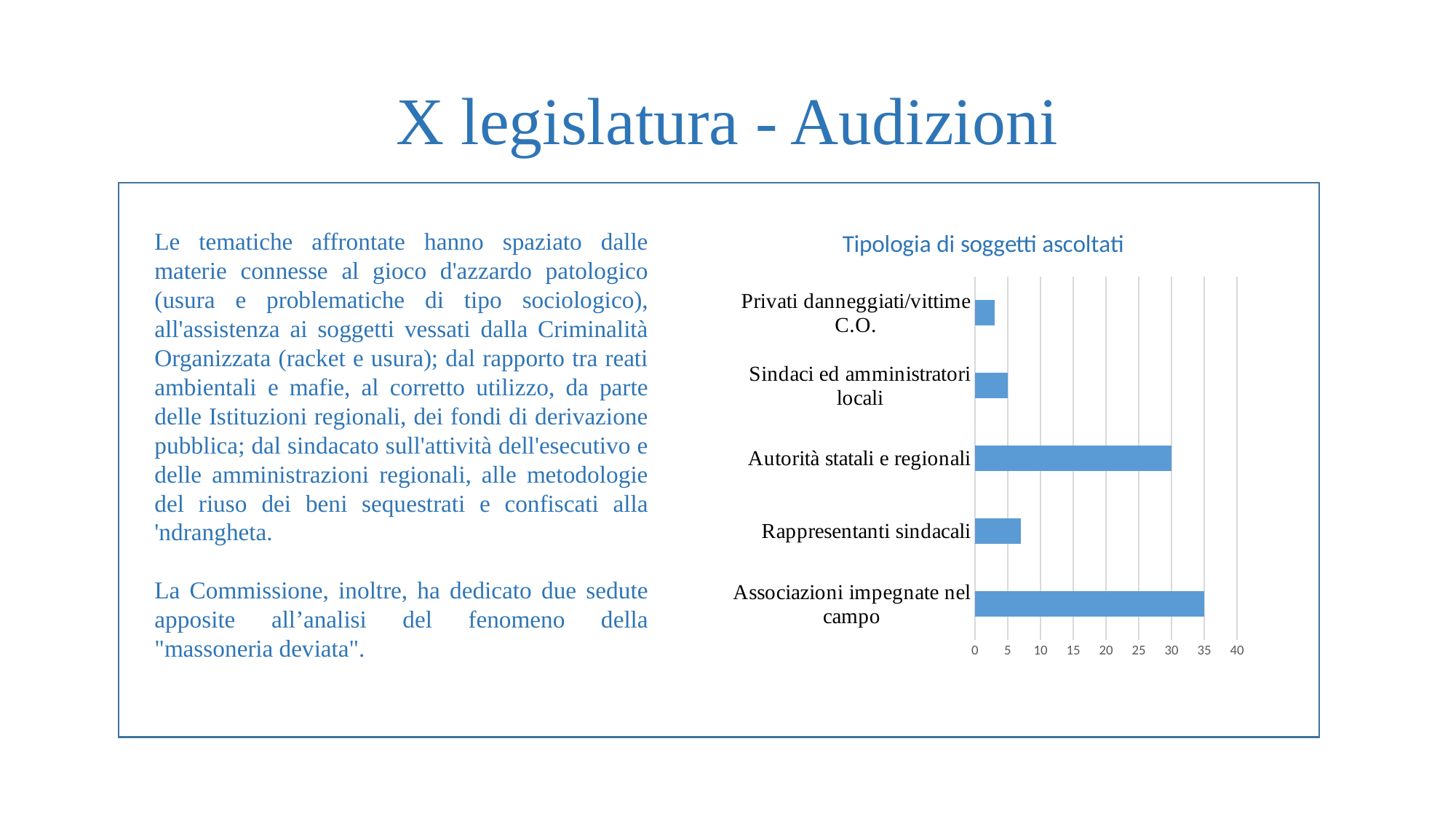
Is the value for Rappresentanti sindacali greater or less than 5? greater What is the title of the chart? Tipologia di soggetti ascoltati How many categories does the chart show? 5 What is the value for Associazioni impegnate nel campo? 35 What is the value for Autorità statali e regionali? 30 What kind of chart is shown on the slide? bar chart Which is larger, the value for Rappresentanti sindacali or the value for Sindaci ed amministratori locali? Rappresentanti sindacali Which category has the highest value? Associazioni impegnate nel campo What is the value for Sindaci ed amministratori locali? 5 What is the difference between the values for Associazioni impegnate nel campo and Autorità statali e regionali? 5 Which category has the lowest value? Privati danneggiati/vittime C.O. Is the value for Privati danneggiati/vittime C.O. greater or less than 5? less